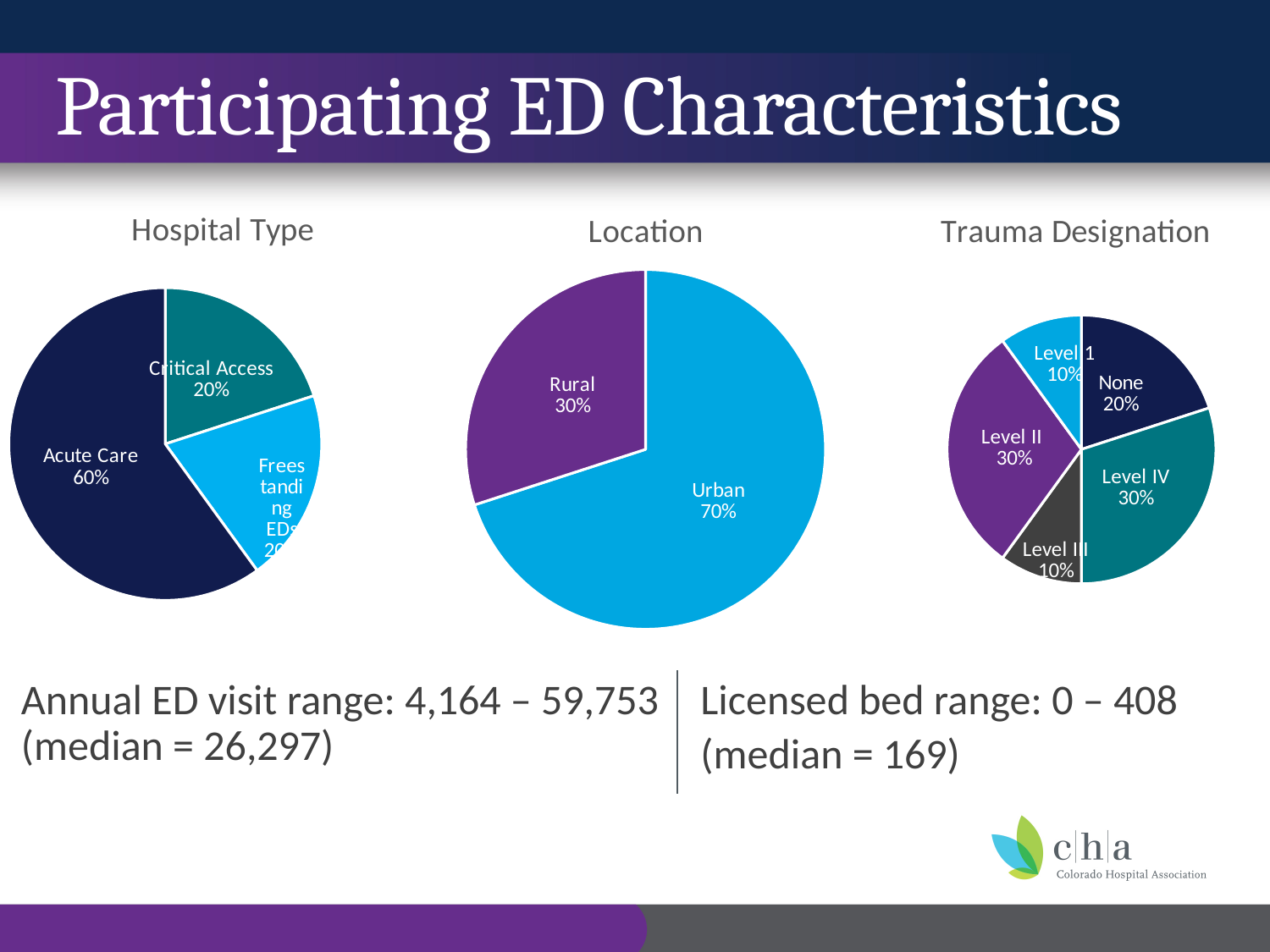
In the Location chart, what percentage of EDs are Rural? 30% In the Trauma Designation chart, which is larger, Level IV or Level III? Level IV How many pie charts are shown on the slide? 3 In the Location chart, what is the difference between the Urban and Rural shares? 40% In the Trauma Designation chart, what percentage of EDs have no trauma designation (None)? 20% What type of chart is used for the Location data? Pie chart In the Hospital Type chart, what share of participating EDs are Acute Care? 60% In the Location chart, what percentage of EDs are Urban? 70% In the Trauma Designation chart, what percentage of EDs are Level II? 30% In the Hospital Type chart, which hospital type has the largest slice? Acute Care In the Hospital Type chart, what percentage is Critical Access? 20% In the Trauma Designation chart, how many categories are shown? 5